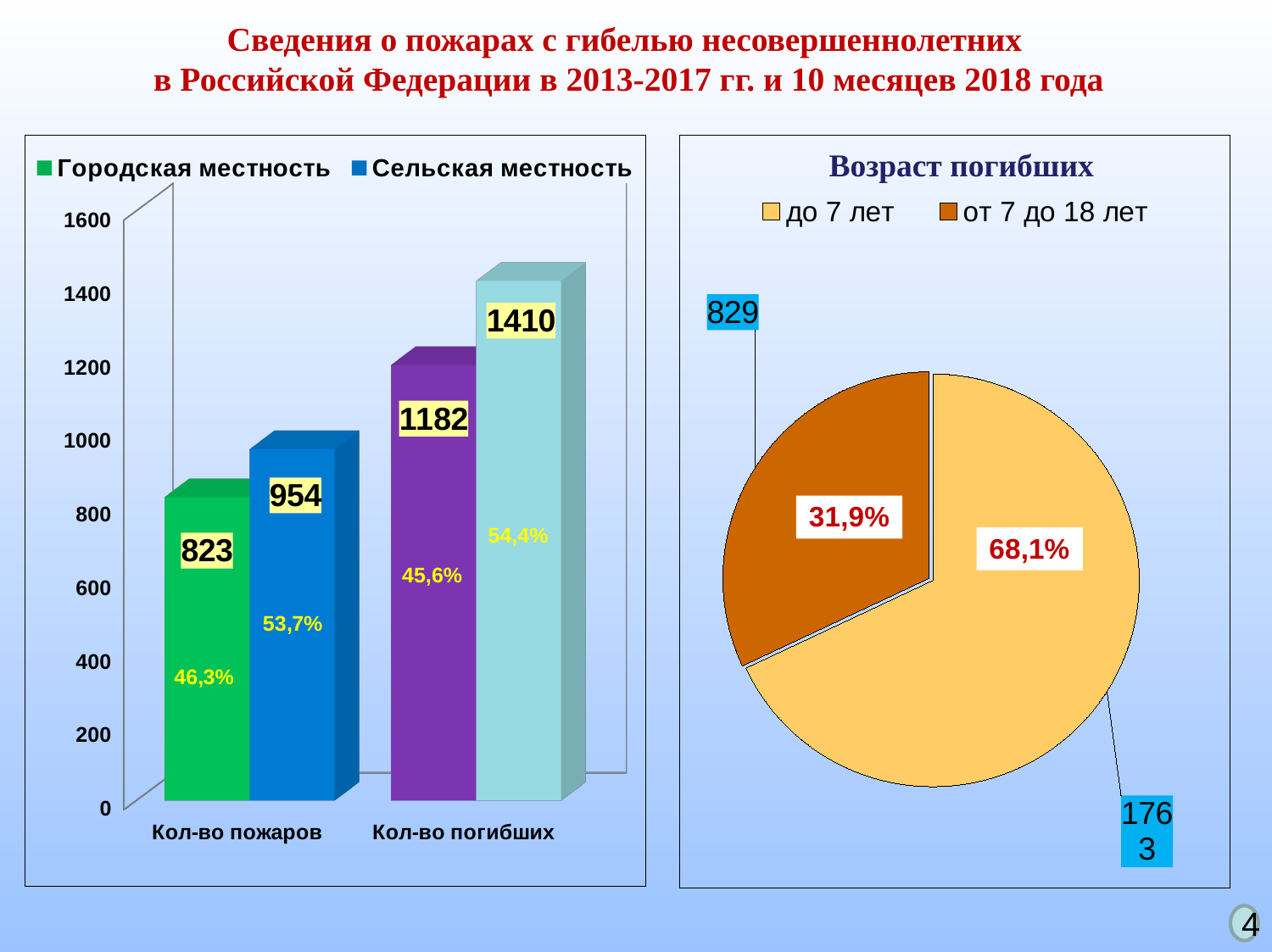
On the left bar chart, how many series does the legend list? 2 On the Возраст погибших chart, what is the value shown for the от 7 до 18 лет slice? 829 On the left bar chart, what is the difference between the Сельская местность and Городская местность values in the Кол-во погибших category? 228 On the left bar chart, what is the value for Сельская местность in the Кол-во погибших category? 1410 What kind of chart is the Возраст погибших chart? Pie chart On the left bar chart, what is the value for Сельская местность in the Кол-во пожаров category? 954 What kind of chart is the chart on the left of the slide? Bar chart On the left bar chart, what is the value for Городская местность in the Кол-во пожаров category? 823 On the left bar chart, what percentage is shown on the Городская местность bar in the Кол-во погибших category? 45,6% On the Возраст погибших chart, which slice is the largest? до 7 лет On the Возраст погибших chart, what share of the pie is the до 7 лет slice? 68,1% On the left bar chart, which series has the larger value in the Кол-во пожаров category? Сельская местность